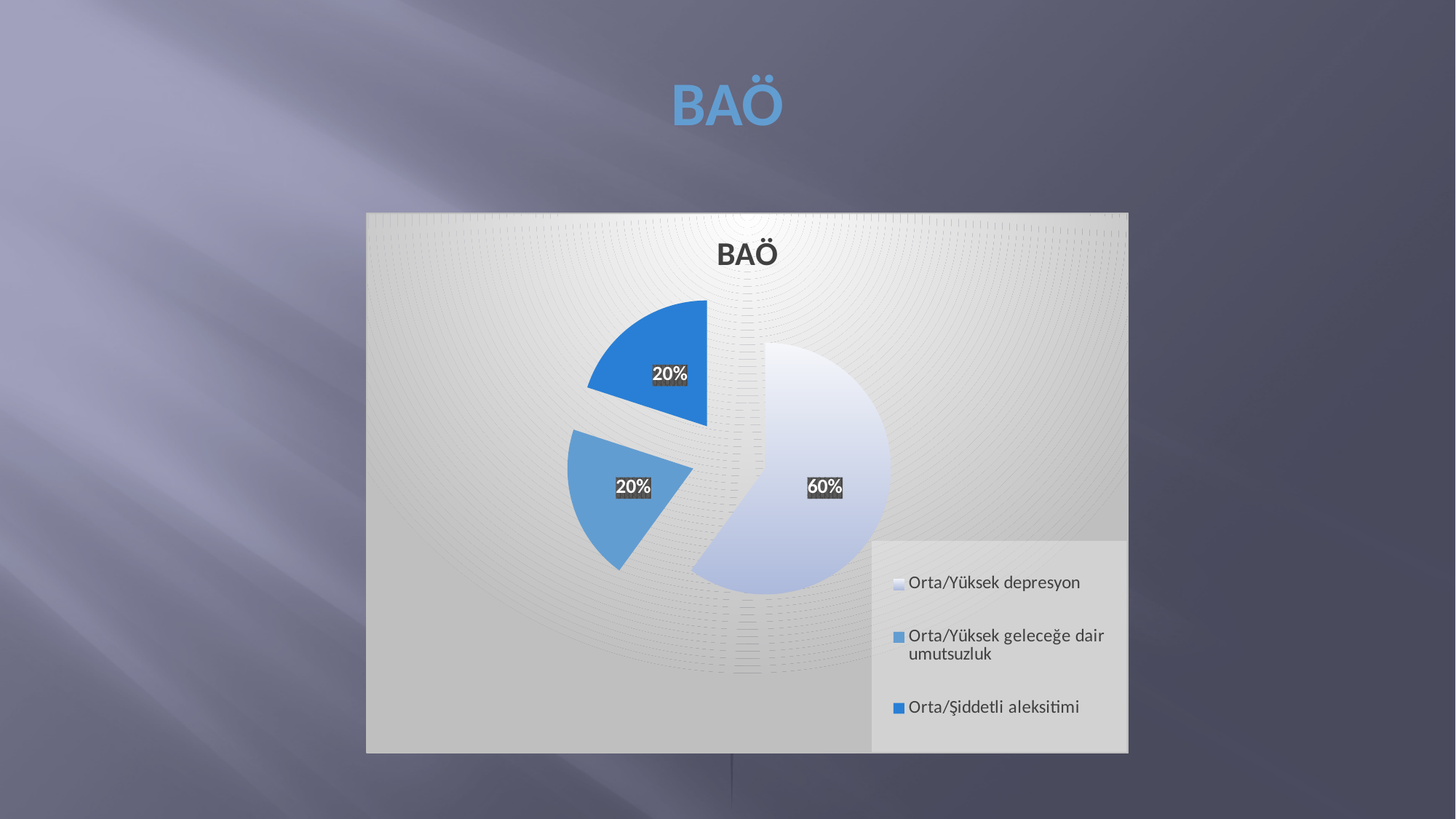
Which category has the largest slice of the pie? Orta/Yüksek depresyon Is the share for Orta/Yüksek depresyon greater or less than 50%? greater What is the title of the chart? BAÖ What is the difference between the share for Orta/Yüksek depresyon and the share for Orta/Şiddetli aleksitimi? 40% Which legend entry is shown in the darkest blue colour? Orta/Şiddetli aleksitimi What kind of chart is shown on the slide? pie chart How many slices does the pie chart have? 3 Which is larger, the share for Orta/Yüksek depresyon or the share for Orta/Yüksek geleceğe dair umutsuzluk? Orta/Yüksek depresyon What share of the pie is Orta/Yüksek geleceğe dair umutsuzluk? 20% What share of the pie is Orta/Yüksek depresyon? 60% How many entries does the legend list? 3 What share of the pie is Orta/Şiddetli aleksitimi? 20%